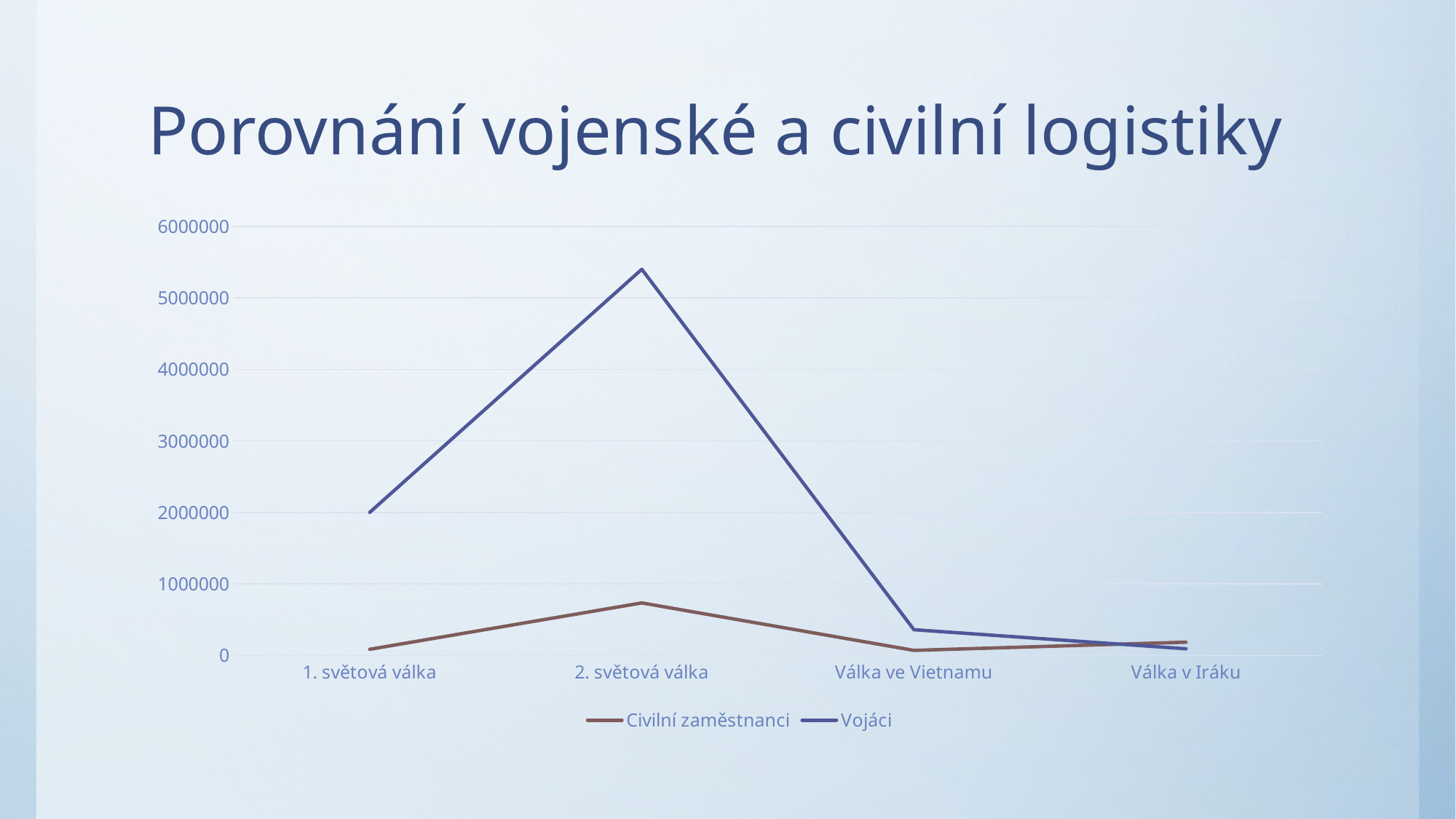
How many categories are shown on the x axis? 4 For which category is the value of Vojáci lowest? Válka v Iráku What is the title of the chart on the slide? Porovnání vojenské a civilní logistiky Which series has the larger value at 2. světová válka, Civilní zaměstnanci or Vojáci? Vojáci Which series is drawn with the blue line? Vojáci For which category is the value of Vojáci highest? 2. světová válka Is the value for Vojáci at Válka ve Vietnamu greater or less than 1000000? less Does the value of Vojáci rise or fall from 2. světová válka to Válka v Iráku? fall How many series does the legend list? 2 What kind of chart is shown on the slide? line chart Is the value for Vojáci at 2. světová válka greater or less than 5000000? greater For which category is the value of Civilní zaměstnanci highest? 2. světová válka